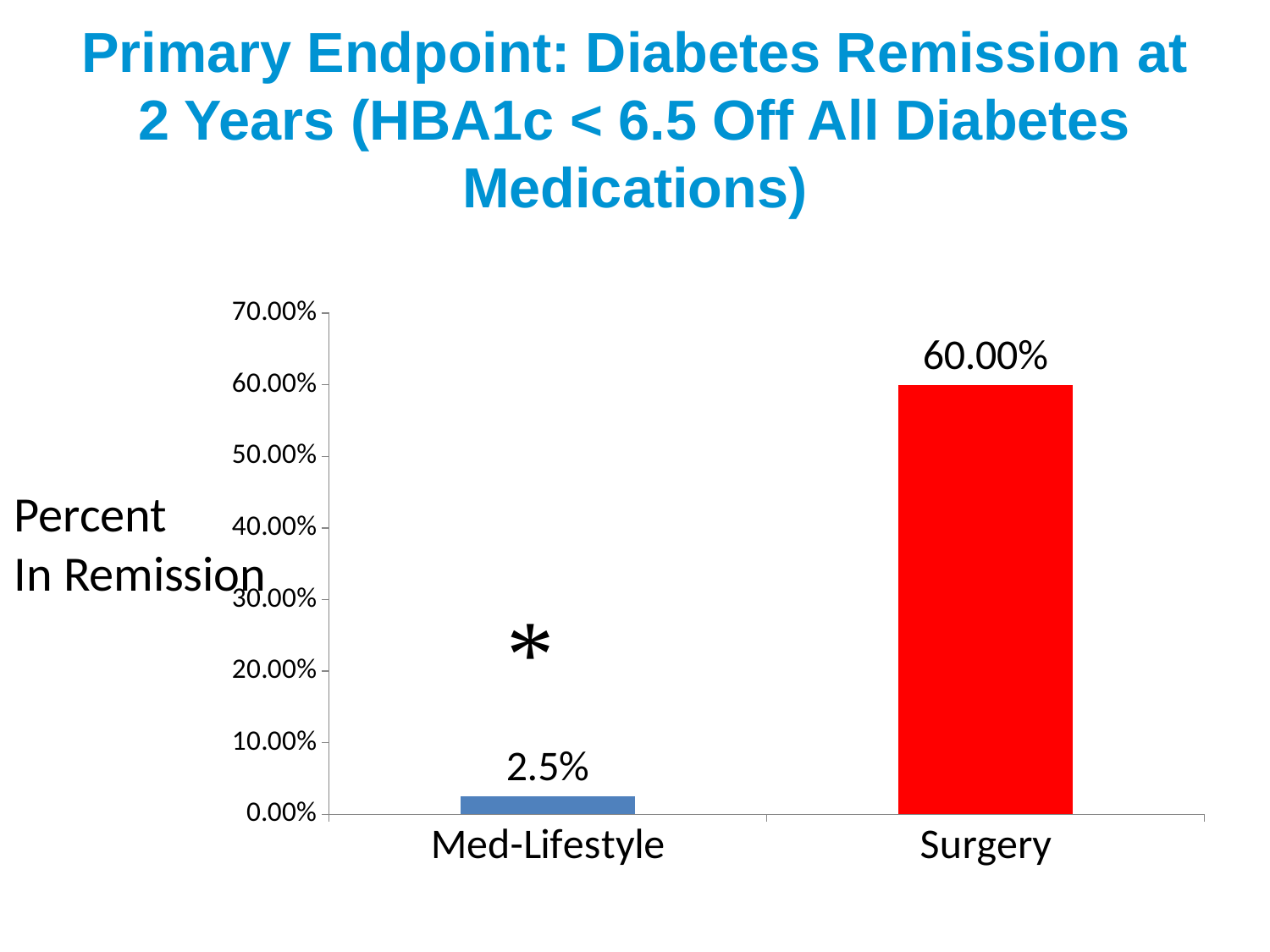
What is the value for Surgery? 60.00% What kind of chart is shown on the slide? Bar chart Is the value for Med-Lifestyle greater or less than 10.00%? less Which category has the lowest value? Med-Lifestyle Which category has the highest value? Surgery What is the label on the y axis of the chart? Percent In Remission What colour is the Surgery bar? Red How many categories are shown on the x axis? 2 Which is larger, the value for Surgery or the value for Med-Lifestyle? Surgery What is the value for Med-Lifestyle? 2.5% Is the value for Surgery greater or less than 50.00%? greater What is the difference between the Surgery and Med-Lifestyle values? 57.5%